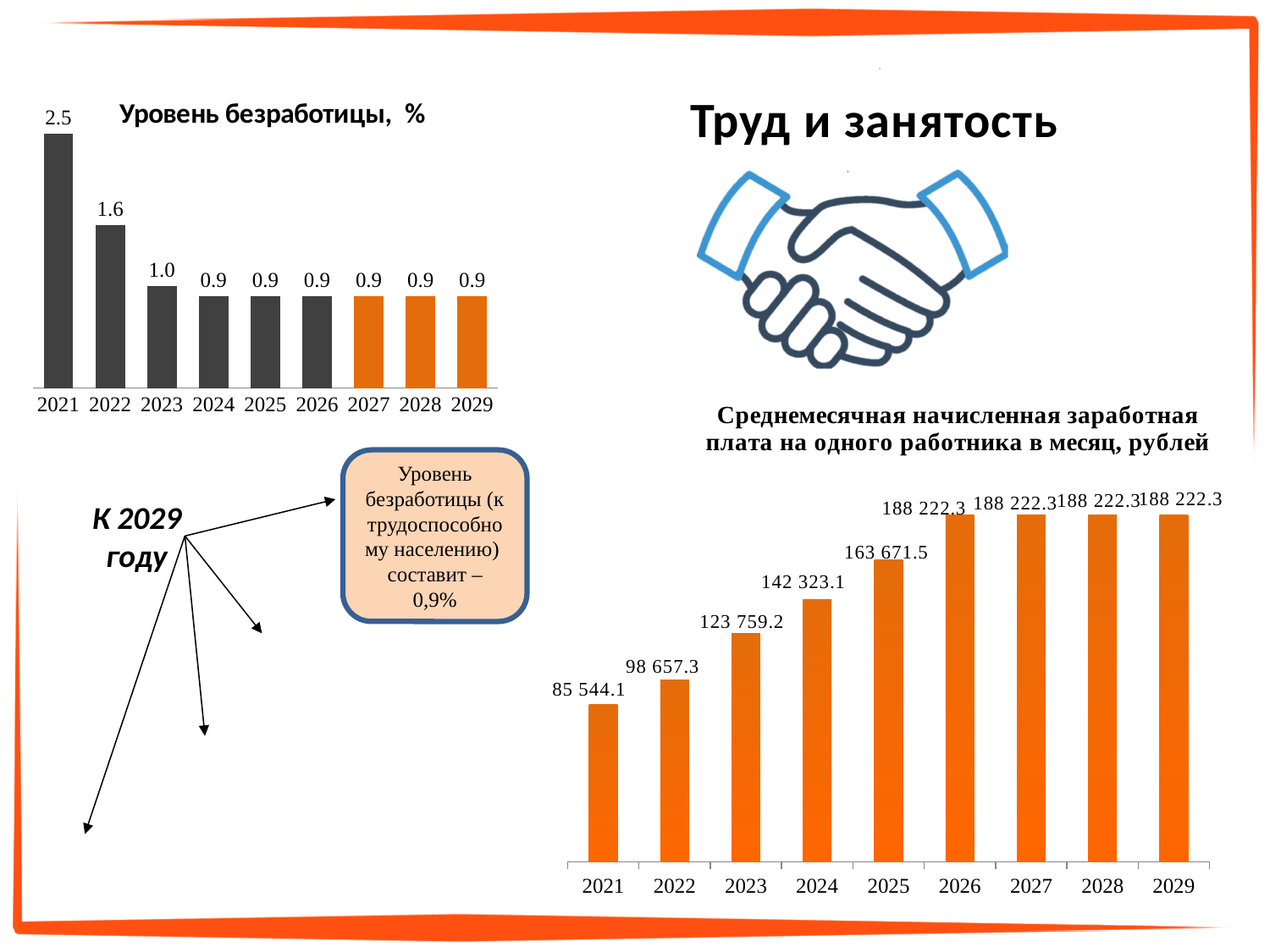
In the chart "Уровень безработицы, %", do the values rise or fall from 2021 to 2024? fall In the chart "Среднемесячная начисленная заработная плата на одного работника в месяц, рублей", which is larger, the value for 2023 or the value for 2025? 2025 In the chart "Среднемесячная начисленная заработная плата на одного работника в месяц, рублей", what is the value for 2021? 85 544.1 In the chart "Уровень безработицы, %", how many years are shown on the x axis? 9 In the chart "Уровень безработицы, %", which year has the highest value? 2021 In the chart "Уровень безработицы, %", what is the value for 2023? 1.0 In the chart "Среднемесячная начисленная заработная плата на одного работника в месяц, рублей", what is the value for 2024? 142 323.1 In the chart "Среднемесячная начисленная заработная плата на одного работника в месяц, рублей", which year has the lowest value? 2021 In the chart "Среднемесячная начисленная заработная плата на одного работника в месяц, рублей", what is the difference between the values for 2022 and 2021? 13 113.2 In the chart "Уровень безработицы, %", what is the difference between the values for 2021 and 2022? 0.9 In the chart "Уровень безработицы, %", what is the value for 2021? 2.5 What type of chart is "Среднемесячная начисленная заработная плата на одного работника в месяц, рублей"? bar chart